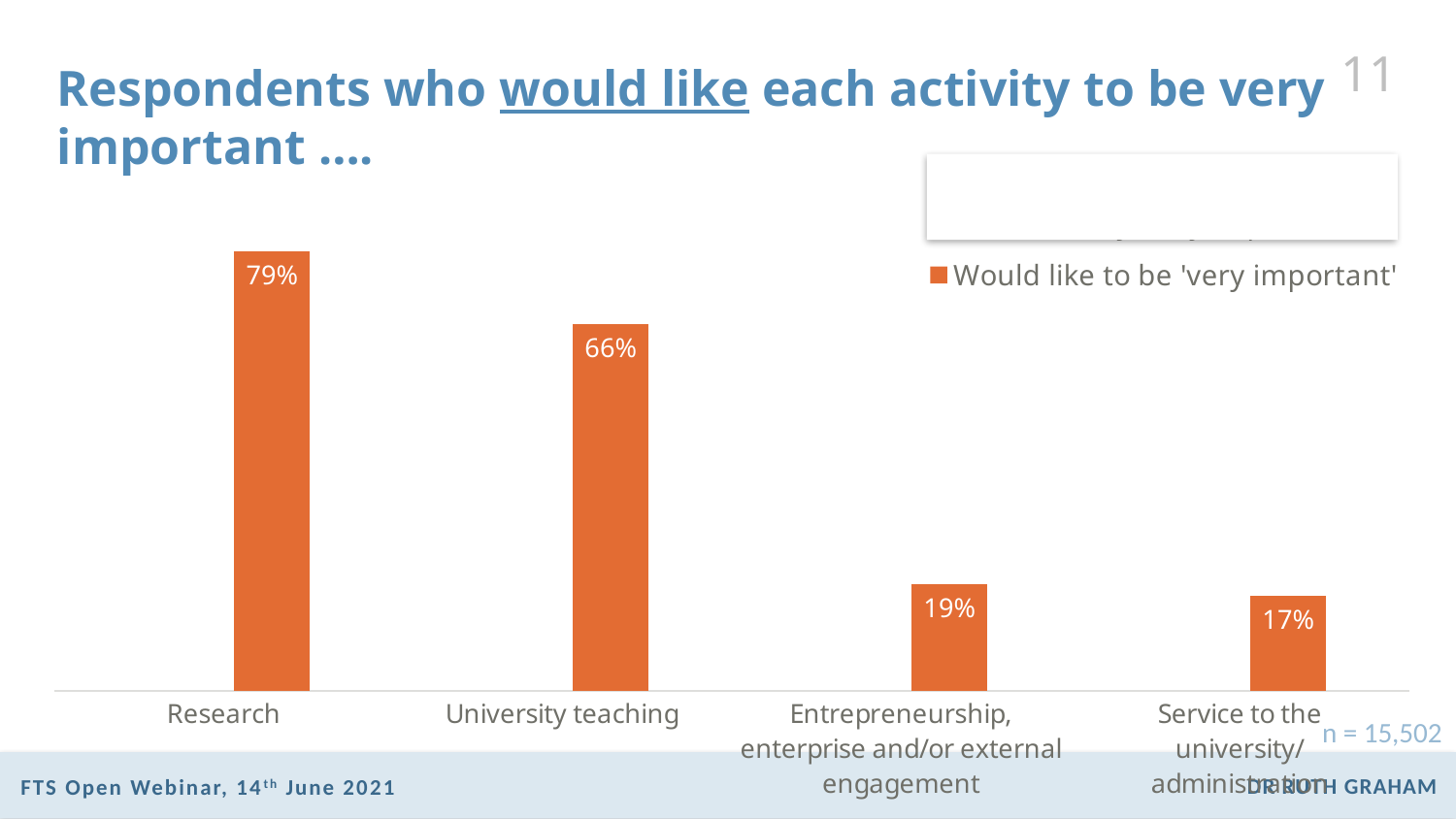
How many activities are shown on the chart? 4 Which activity has the lowest percentage? Service to the university/administration Which is larger, the value for University teaching or the value for Entrepreneurship, enterprise and/or external engagement? University teaching What is the difference between the values for Entrepreneurship, enterprise and/or external engagement and Service to the university/administration? 2% What is the sample size (n) noted on the slide? n = 15,502 What is the difference between the values for Research and University teaching? 13% What is the value shown for Service to the university/administration? 17% What percentage of respondents would like Research to be 'very important'? 79% What is the value shown for University teaching? 66% What is the value shown for Entrepreneurship, enterprise and/or external engagement? 19% What kind of chart is shown on the slide? Bar chart Which activity has the highest percentage of respondents who would like it to be 'very important'? Research